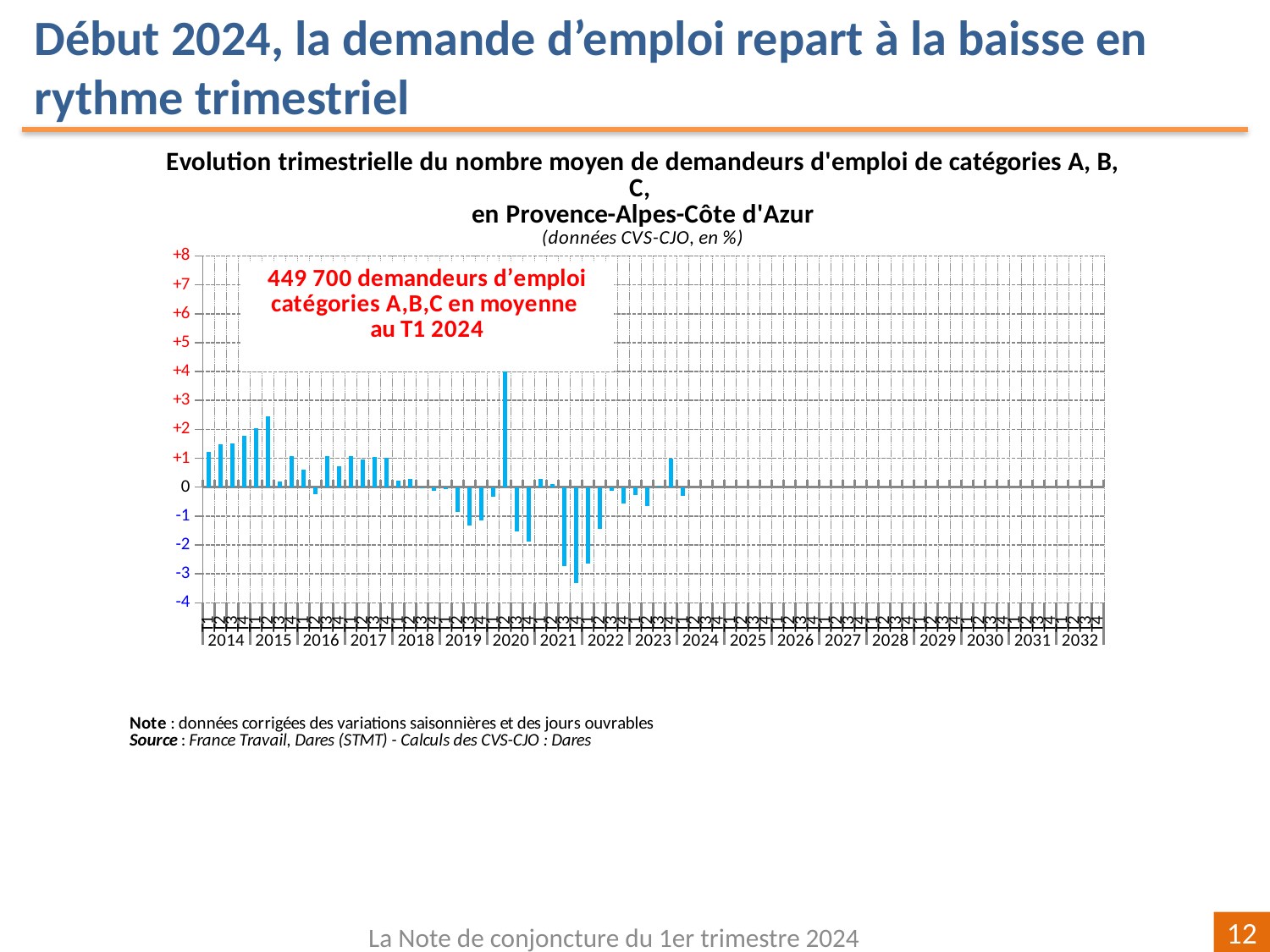
Is the lowest bar in 2021 greater or less than -2? less What kind of chart is shown on the slide? bar chart Which is taller: the tallest bar in 2020 or the tallest bar in 2015? 2020 According to the text box on the chart, how many demandeurs d'emploi catégories A,B,C were there on average in T1 2024? 449 700 Is the tallest bar in 2020 greater or less than +3? greater Which region does the chart title say the data covers? Provence-Alpes-Côte d'Azur In which year does the tallest bar of the chart appear? 2020 Do the bars generally rise or fall from the start of 2014 to mid-2015? rise In which year does the lowest (most negative) bar of the chart appear? 2021 Is the last plotted bar, in 2024, greater or less than 0? less